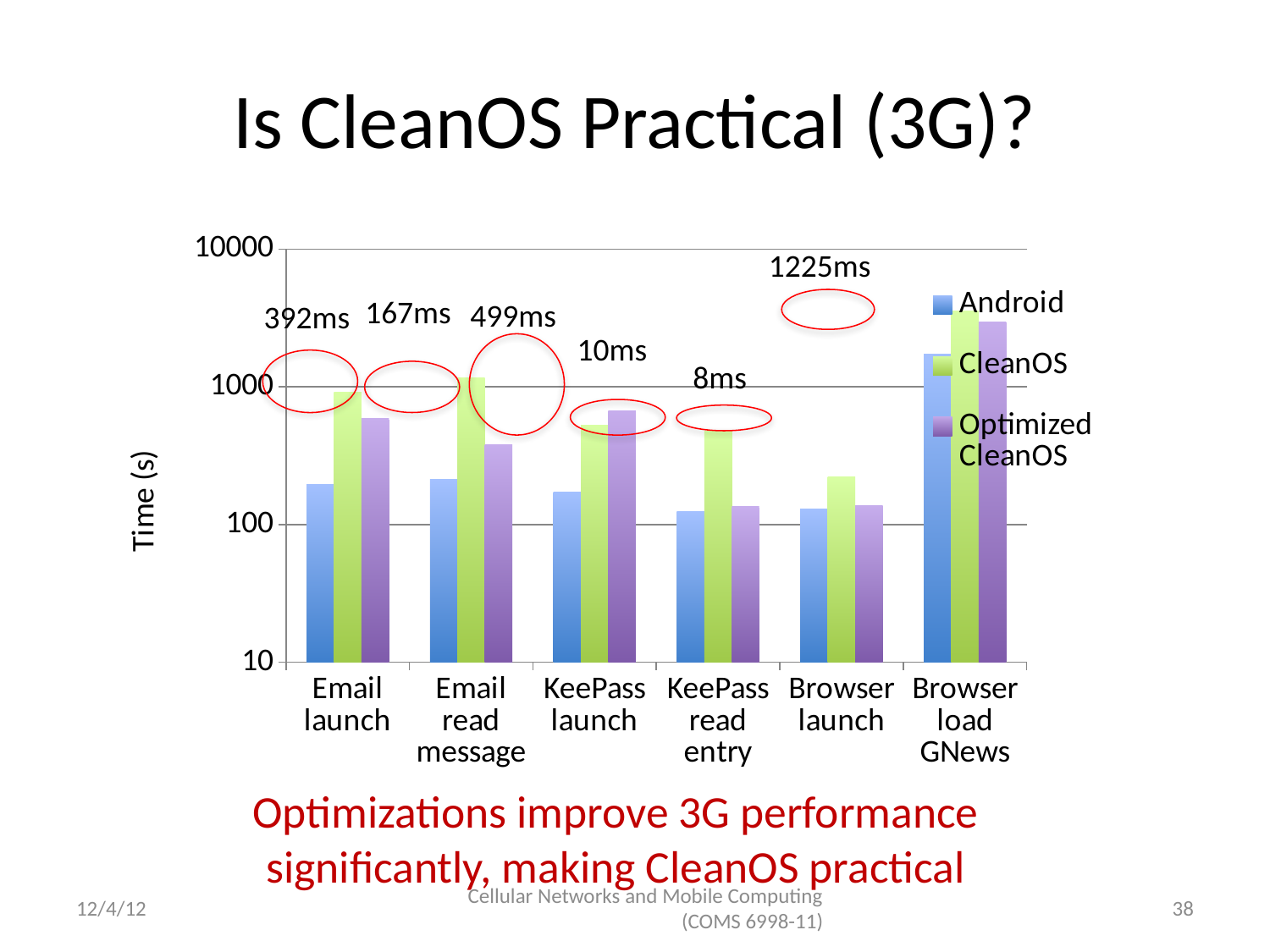
Is the CleanOS value for Browser launch greater or less than 1000? less Is the Android value for Email launch greater or less than 100? greater Is the CleanOS value for Email read message greater or less than 1000? greater How many series does the chart's legend list? 3 How many categories are shown along the x axis of the chart? 6 Which category has the highest Android value? Browser load GNews What are the three series listed in the chart's legend? Android, CleanOS, Optimized CleanOS What kind of chart is shown on the slide? bar chart For Email launch, which is larger: the CleanOS value or the Optimized CleanOS value? CleanOS For KeePass read entry, which is larger: the CleanOS value or the Optimized CleanOS value? CleanOS What is the label on the chart's y axis? Time (s)